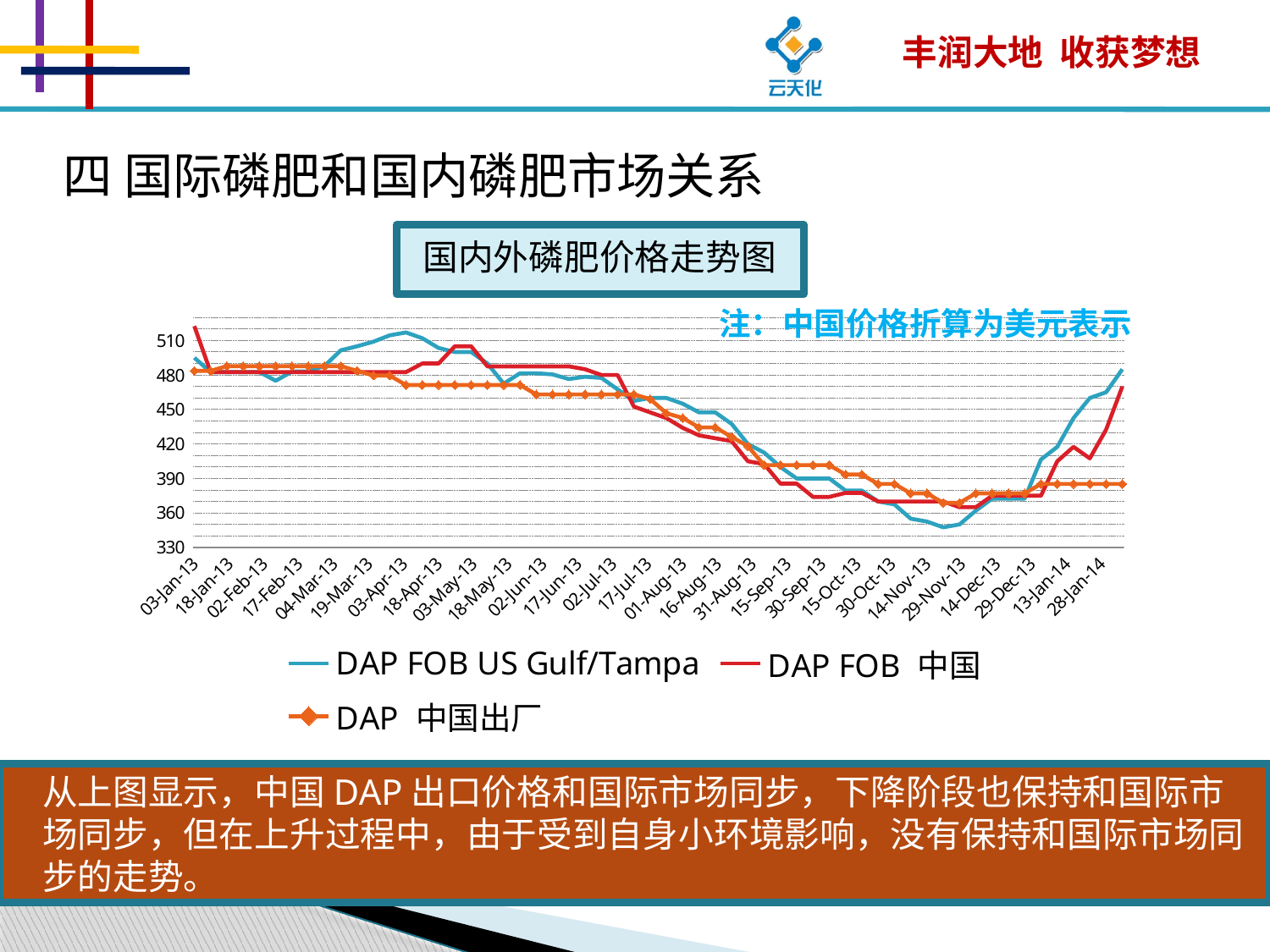
Which series reaches the lowest value on the chart? DAP FOB US Gulf/Tampa At 29-Nov-13, which is higher: DAP 中国出厂 or DAP FOB US Gulf/Tampa? DAP 中国出厂 What is the title of the chart? 国内外磷肥价格走势图 Do the DAP FOB US Gulf/Tampa values rise or fall from 03-Apr-13 to 29-Nov-13? fall What kind of chart is shown on the slide? line chart Is the value of DAP FOB 中国 at 03-Jan-13 greater or less than 510? greater At 28-Jan-14, which is higher: DAP FOB US Gulf/Tampa or DAP 中国出厂? DAP FOB US Gulf/Tampa Is the value of DAP 中国出厂 at 29-Nov-13 greater or less than 390? less How many series does the legend list? 3 Is the value of DAP FOB US Gulf/Tampa at 28-Jan-14 greater or less than 450? greater Which series is drawn with diamond markers? DAP 中国出厂